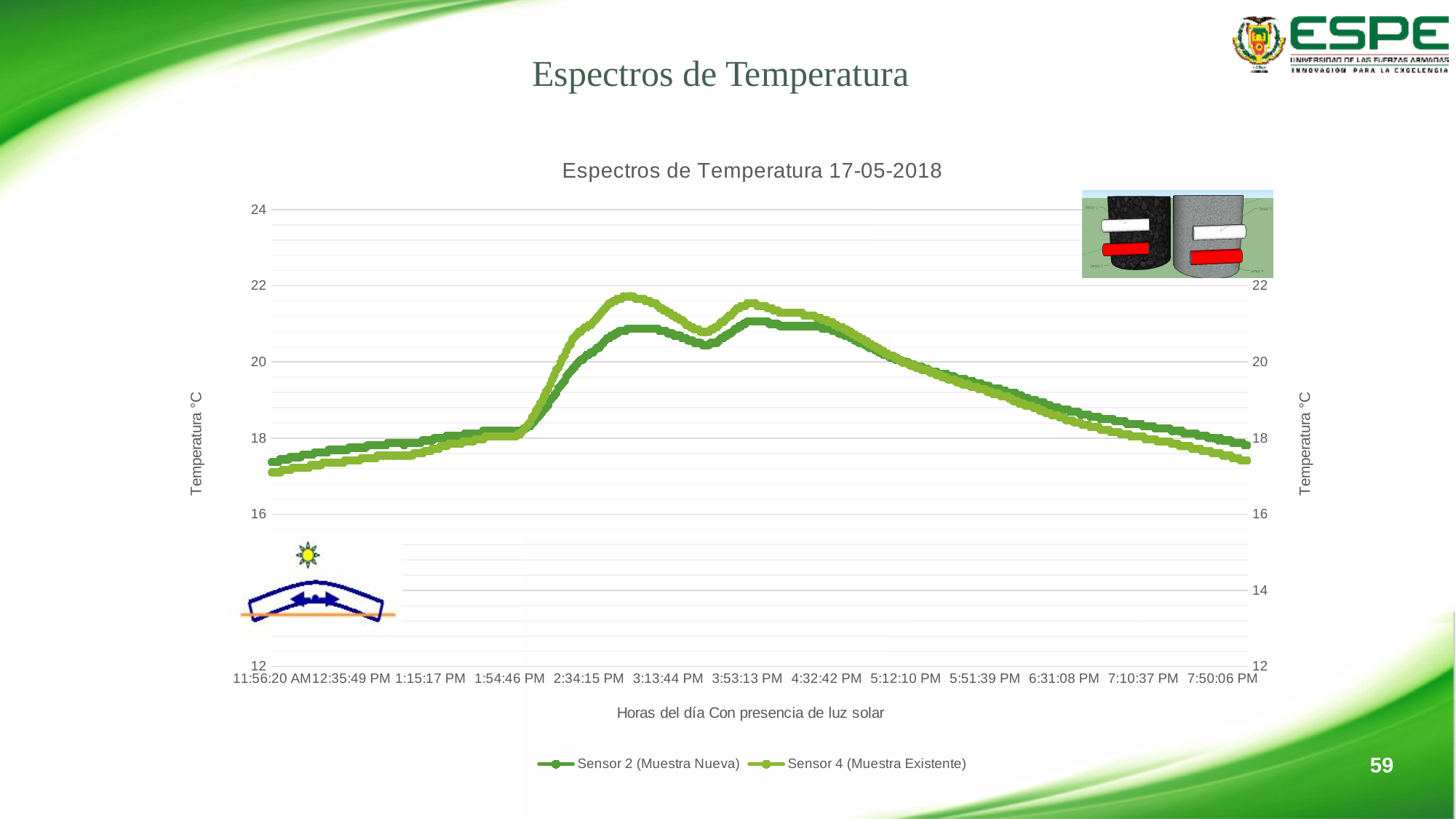
Is the peak value of Sensor 4 (Muestra Existente) greater or less than 20? greater How many series does the legend list? 2 Which series reaches the highest temperature on the chart? Sensor 4 (Muestra Existente) Do the temperature values rise or fall between 4:32:42 PM and 7:50:06 PM? fall At 11:56:20 AM, which series has the higher temperature, Sensor 2 (Muestra Nueva) or Sensor 4 (Muestra Existente)? Sensor 2 (Muestra Nueva) What kind of chart is shown on the slide? Line chart Is the peak value of Sensor 2 (Muestra Nueva) greater or less than 22? less What is the title of the chart? Espectros de Temperatura 17-05-2018 Is the value for Sensor 4 (Muestra Existente) at 11:56:20 AM greater or less than 18? less Do the temperature values rise or fall between 1:54:46 PM and 3:13:44 PM? rise What is the x-axis title of the chart? Horas del día Con presencia de luz solar